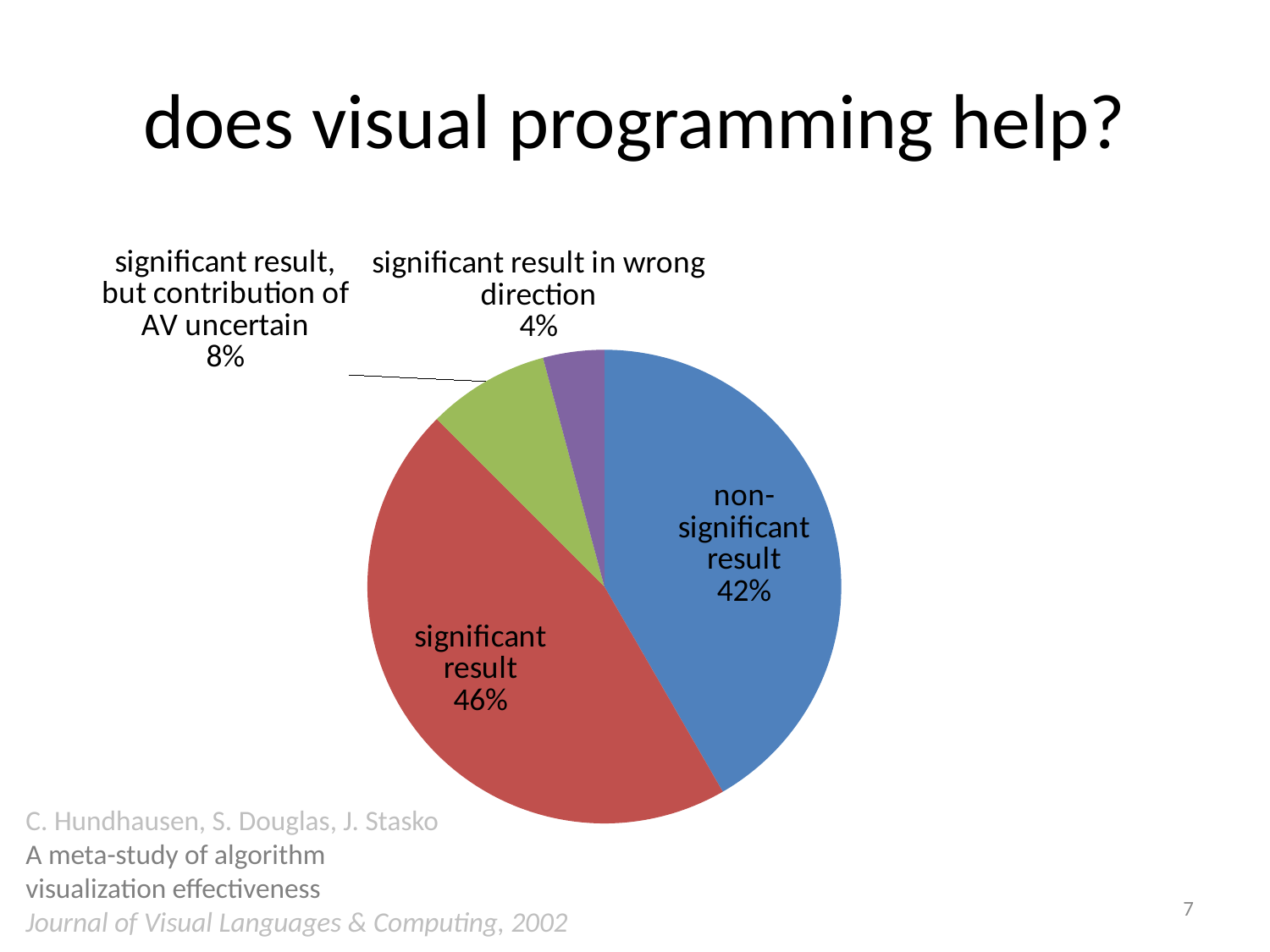
Which is larger: the "significant result, but contribution of AV uncertain" slice or the "significant result in wrong direction" slice? significant result, but contribution of AV uncertain What share of the pie is labelled "significant result"? 46% What colour is the "non-significant result" slice? blue What share of the pie is labelled "significant result in wrong direction"? 4% What is the combined share of the "significant result, but contribution of AV uncertain" and "significant result in wrong direction" slices? 12% What share of the pie is labelled "non-significant result"? 42% How many slices does the pie chart have? 4 Which slice of the pie is the largest? significant result What is the difference in percentage points between the "significant result" slice and the "non-significant result" slice? 4 What kind of chart is shown on the slide? pie chart Which slice of the pie is the smallest? significant result in wrong direction